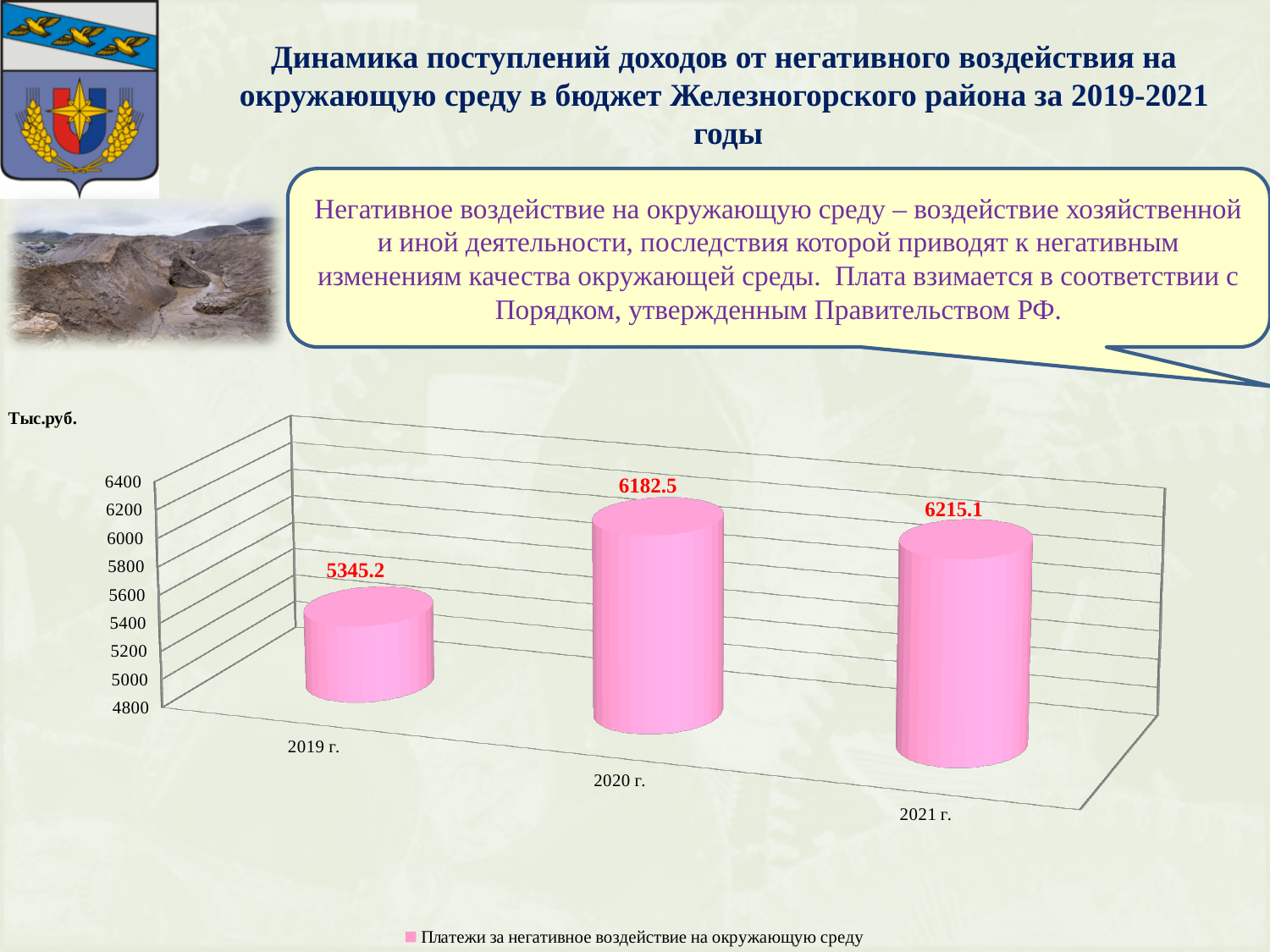
Which is larger, the value for 2020 г. or the value for 2021 г.? 2021 г. What is the value for 2019 г.? 5345.2 Is the value for 2019 г. greater or less than 5600? less What is the value for 2020 г.? 6182.5 Which year has the highest value? 2021 г. What is the value for 2021 г.? 6215.1 How many years are shown on the chart? 3 What kind of chart is shown on the slide? bar chart What is the difference between the values for 2021 г. and 2020 г.? 32.6 Do the values rise or fall from 2019 г. to 2021 г.? rise What is the difference between the values for 2020 г. and 2019 г.? 837.3 Which year has the lowest value? 2019 г.